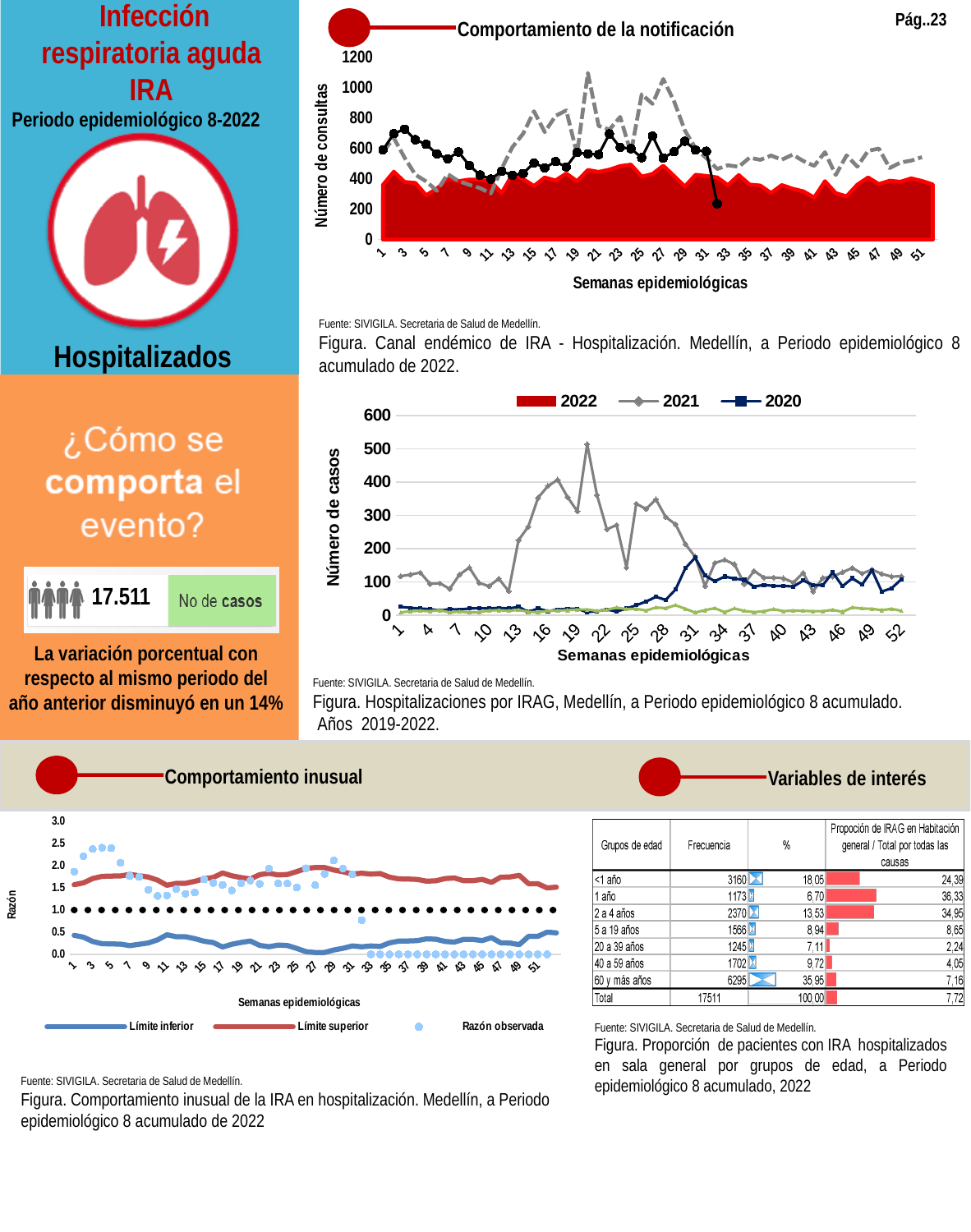
In the chart titled 'Comportamiento de la notificación', is the peak of the grey dashed line around week 20 greater or less than 1000? greater In the 'Comportamiento inusual' chart at the bottom left, how many series does the legend list? 3 In the chart titled 'Hospitalizaciones por IRAG', is the value of the 2021 series at week 19 greater or less than 400? less In the chart titled 'Hospitalizaciones por IRAG', how many series does the legend list? 3 In the chart titled 'Comportamiento de la notificación', is the value of the black dotted line at week 32 greater or less than 400? less What kind of chart is the 'Hospitalizaciones por IRAG' chart in the middle of the slide? line chart In the chart titled 'Hospitalizaciones por IRAG', which series has the highest value at week 19? 2021 In the chart titled 'Comportamiento de la notificación' at the top right, what is the label of the y axis? Número de consultas In the chart titled 'Hospitalizaciones por IRAG', which years are listed in the legend? 2022, 2021, 2020